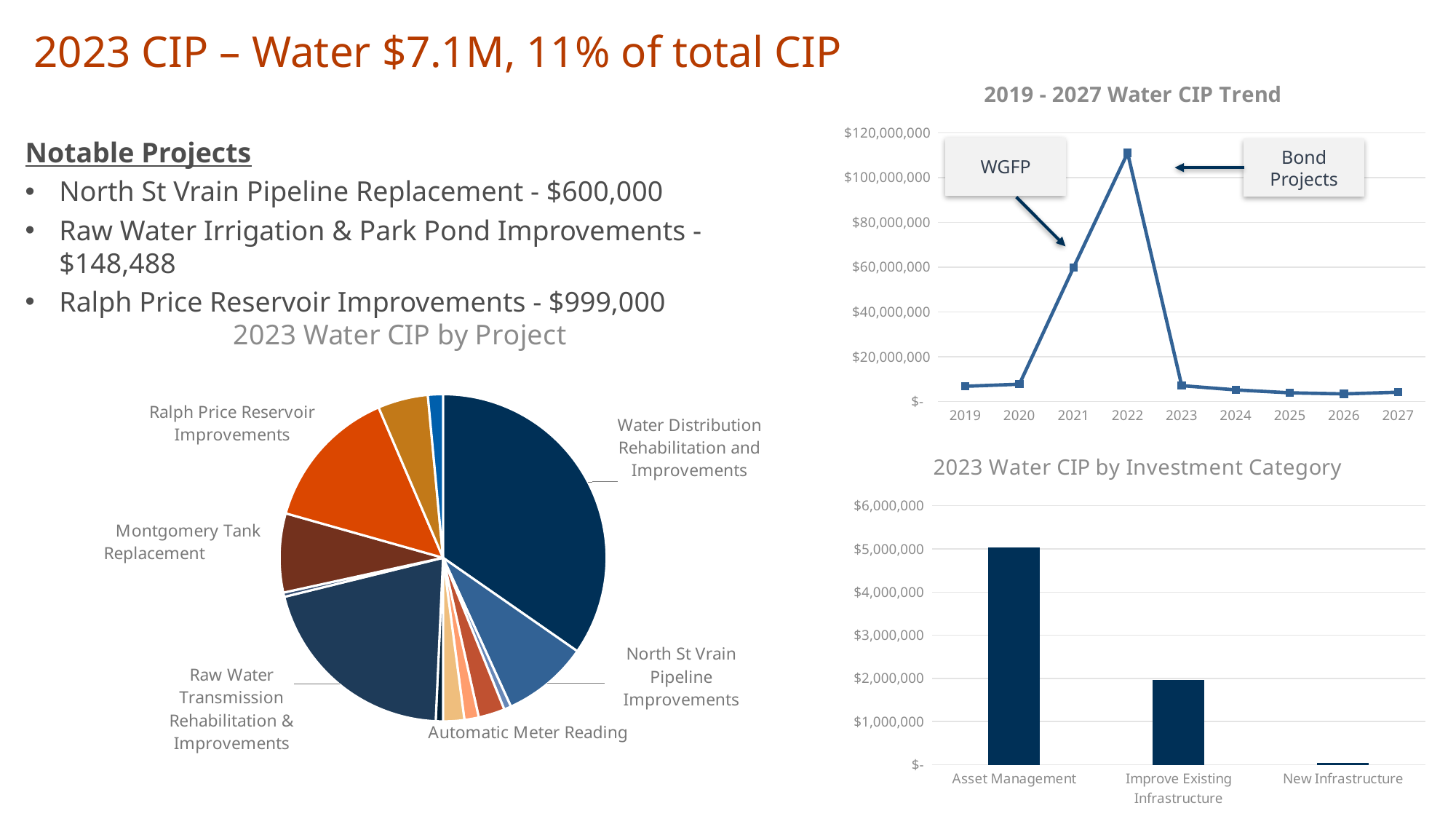
In the '2019 - 2027 Water CIP Trend' chart, is the value for 2023 greater or less than $20,000,000? less In the '2019 - 2027 Water CIP Trend' chart, is the value for 2022 greater or less than $100,000,000? greater What kind of chart is the '2019 - 2027 Water CIP Trend' chart? line chart In the '2023 Water CIP by Investment Category' chart, which category has the lowest value? New Infrastructure In the '2019 - 2027 Water CIP Trend' chart, which year has the highest value? 2022 In the '2023 Water CIP by Project' pie chart, which project has the largest slice? Water Distribution Rehabilitation and Improvements In the '2023 Water CIP by Investment Category' chart, is the value for Asset Management greater or less than $4,000,000? greater In the '2019 - 2027 Water CIP Trend' chart, do the values rise or fall from 2022 to 2027? fall In the '2023 Water CIP by Investment Category' chart, which category has the highest value? Asset Management In the '2019 - 2027 Water CIP Trend' chart, which is larger, the value for 2021 or the value for 2023? 2021 How many years are plotted in the '2019 - 2027 Water CIP Trend' chart? 9